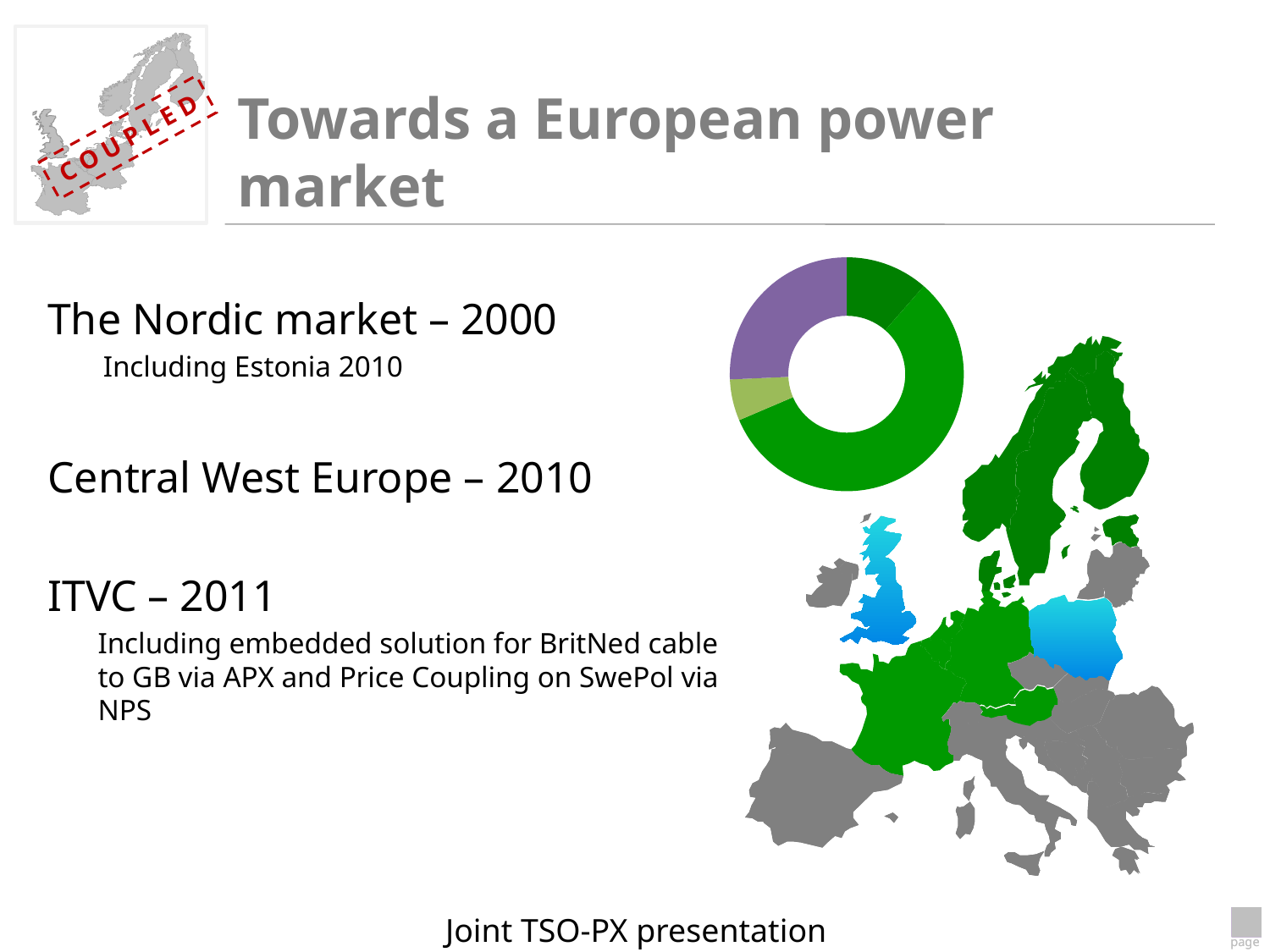
Is the bright green slice or the purple slice larger in the doughnut chart? bright green What kind of chart is shown on the slide? doughnut chart How many slices does the doughnut chart have? 4 Does the doughnut chart show data labels with values on its slices? No Which colour slice is the largest in the doughnut chart? bright green Is the purple slice or the dark green slice larger in the doughnut chart? purple Does the doughnut chart display a legend? No